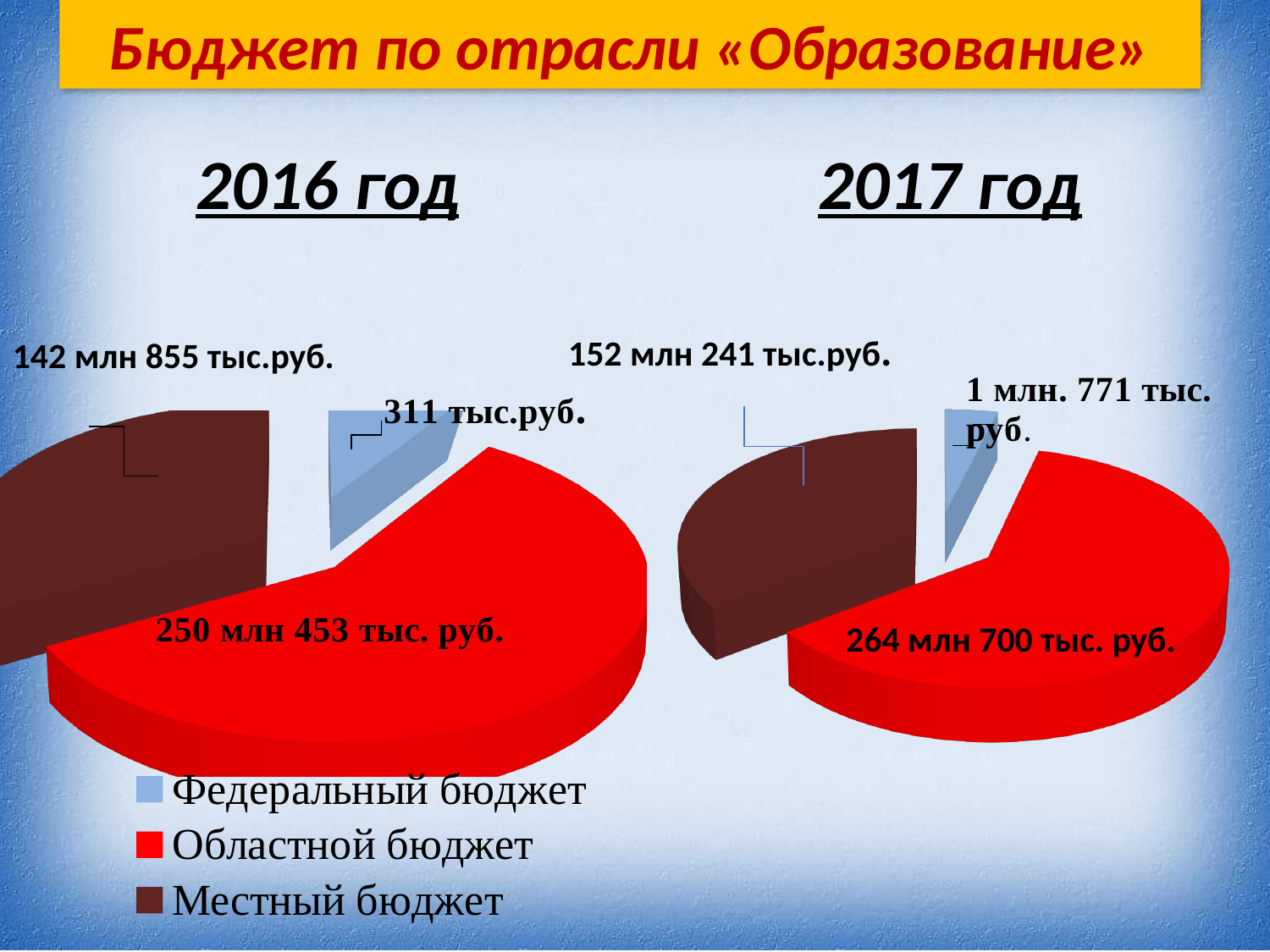
In the 2017 год pie chart, what is the value for Областной бюджет? 264 млн 700 тыс. руб. Which colour represents Местный бюджет in the legend? Dark brown How many slices does the 2017 год pie chart have? 3 In the 2016 год pie chart, what is the value for Федеральный бюджет? 311 тыс.руб. In the 2016 год pie chart, what is the value for Местный бюджет? 142 млн 855 тыс.руб. In the 2016 год pie chart, what is the value for Областной бюджет? 250 млн 453 тыс. руб. Which is larger: Областной бюджет in 2016 год or Областной бюджет in 2017 год? 2017 год In the 2016 год pie chart, which budget source has the largest slice? Областной бюджет In the 2017 год pie chart, what is the value for Местный бюджет? 152 млн 241 тыс.руб. What type of chart is used for 2016 год and 2017 год? Pie chart In the 2017 год pie chart, which budget source has the smallest slice? Федеральный бюджет In the 2017 год pie chart, what is the value for Федеральный бюджет? 1 млн. 771 тыс. руб.